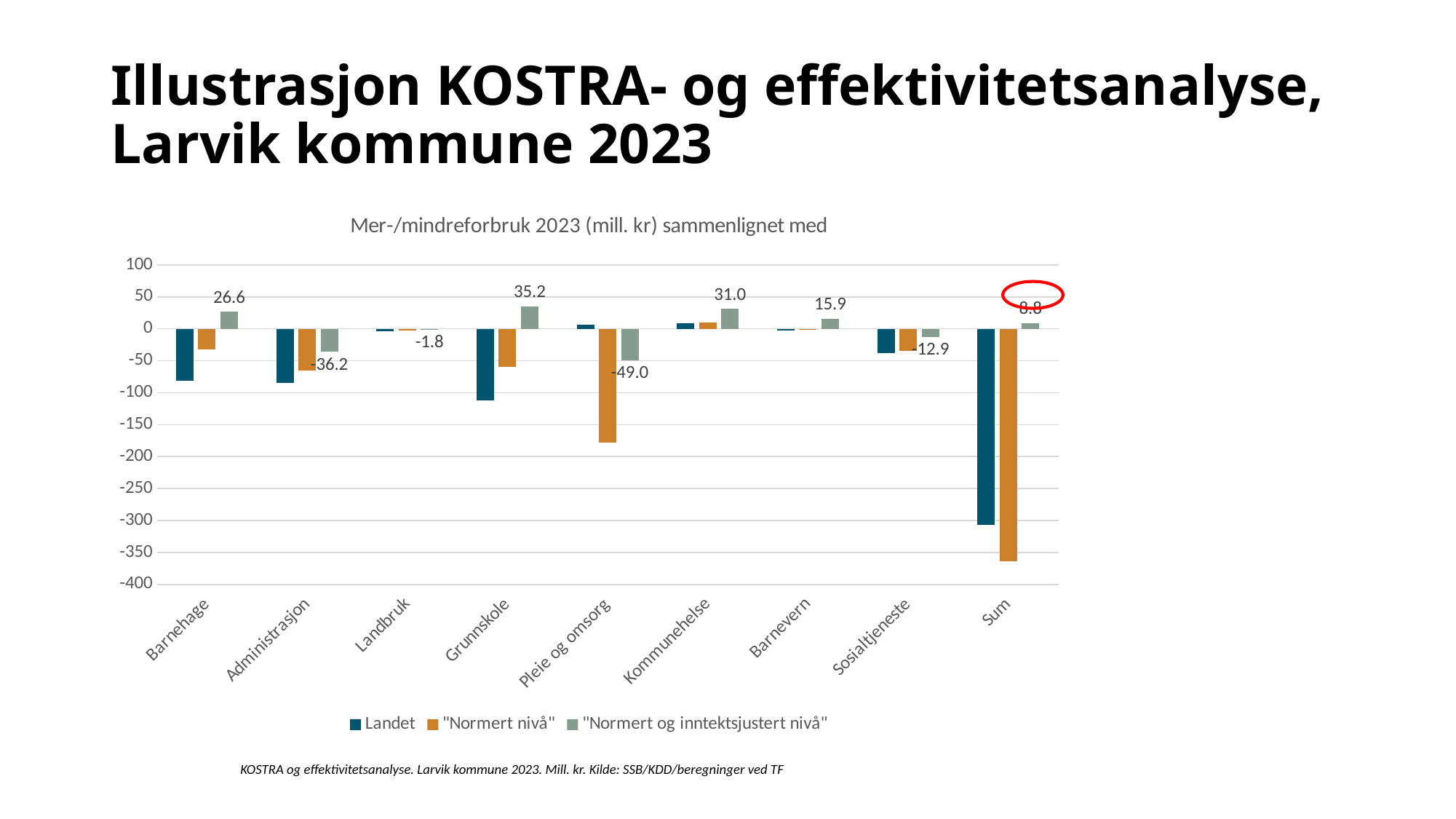
How many categories are shown on the x axis? 9 Which is larger for "Normert og inntektsjustert nivå": Barnehage or Barnevern? Barnehage Which category has the highest value for "Normert og inntektsjustert nivå"? Grunnskole Is the value for "Normert nivå" for Pleie og omsorg greater or less than -150? less What is the difference between the "Normert og inntektsjustert nivå" values for Grunnskole and Kommunehelse? 4.2 What is the title of the chart? Mer-/mindreforbruk 2023 (mill. kr) sammenlignet med How many series does the legend list? 3 Which category has the lowest value for "Normert og inntektsjustert nivå"? Pleie og omsorg What is the value for "Normert og inntektsjustert nivå" for Sum (the circled value)? 8.8 What kind of chart is shown on the slide? bar chart What is the value for "Normert og inntektsjustert nivå" for Pleie og omsorg? -49.0 What is the value for "Normert og inntektsjustert nivå" for Grunnskole? 35.2